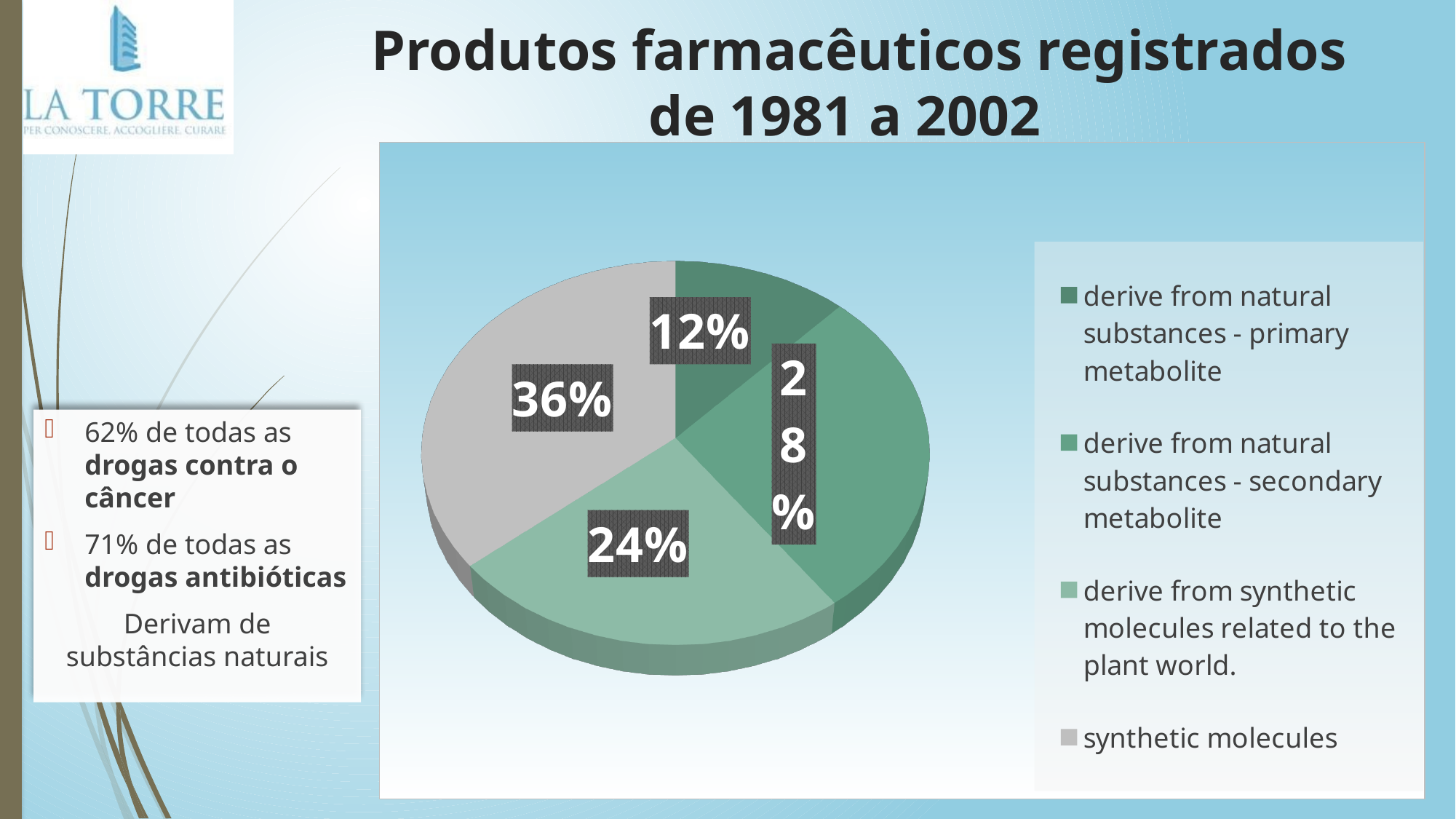
How many entries does the legend list? 4 Which category has the largest slice of the pie? synthetic molecules Which is larger: the slice for 'derive from natural substances - secondary metabolite' or the slice for 'derive from synthetic molecules related to the plant world.'? derive from natural substances - secondary metabolite What is the difference in percentage points between 'synthetic molecules' and 'derive from natural substances - primary metabolite'? 24 What share of the pie is 'derive from natural substances - secondary metabolite'? 28% What share of the pie is 'derive from synthetic molecules related to the plant world.'? 24% What kind of chart is shown on the slide? pie chart How many slices does the pie chart have? 4 Which category has the smallest slice of the pie? derive from natural substances - primary metabolite What share of the pie is 'synthetic molecules'? 36% What colour is the slice for 'synthetic molecules'? grey